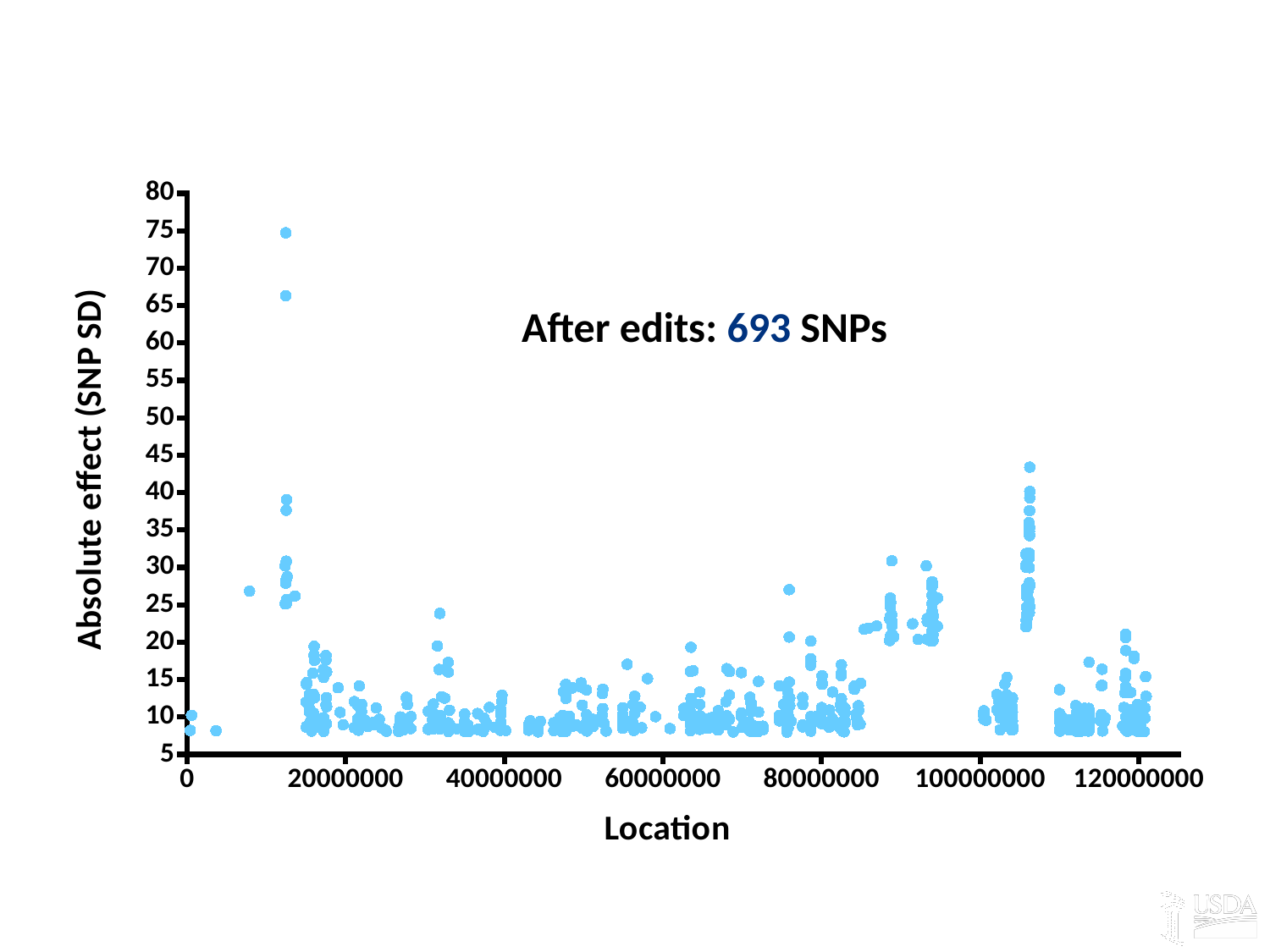
Is the highest point on the chart greater or less than 80? less What is the label of the y axis? Absolute effect (SNP SD) Is the highest point in the cluster near location 106000000 greater or less than 40? greater Is the highest point in the cluster near location 90000000 greater or less than 35? less What is the label of the x axis? Location What kind of chart is shown on the slide? scatter plot Which cluster reaches a higher absolute effect: the one near location 13000000 or the one near location 106000000? the one near location 13000000 How many SNPs are plotted on the chart according to the slide? 693